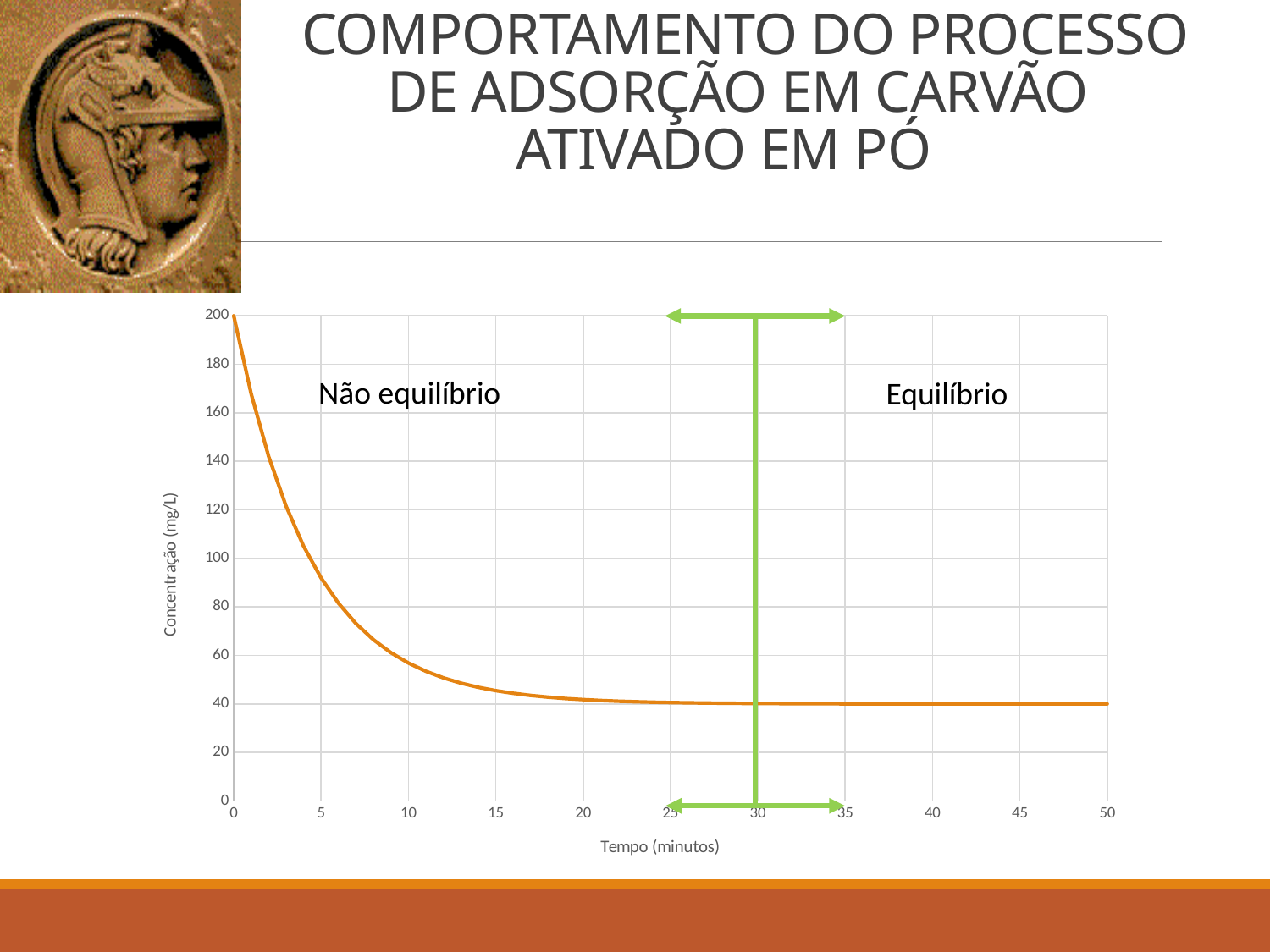
Is the concentration at 10 minutes greater or less than 80? less What is the label of the y axis? Concentração (mg/L) Which is larger, the concentration at 5 minutes or at 20 minutes? 5 minutes What is the concentration at time 0 minutes? 200 Is the concentration at 40 minutes greater or less than 60? less Does the concentration rise or fall as time increases along the x axis? fall What kind of chart is shown on the slide? line chart What is the maximum value shown on the x axis? 50 What is the label of the x axis? Tempo (minutos) At which time is the concentration highest? 0 Is the concentration at 10 minutes greater or less than 40? greater